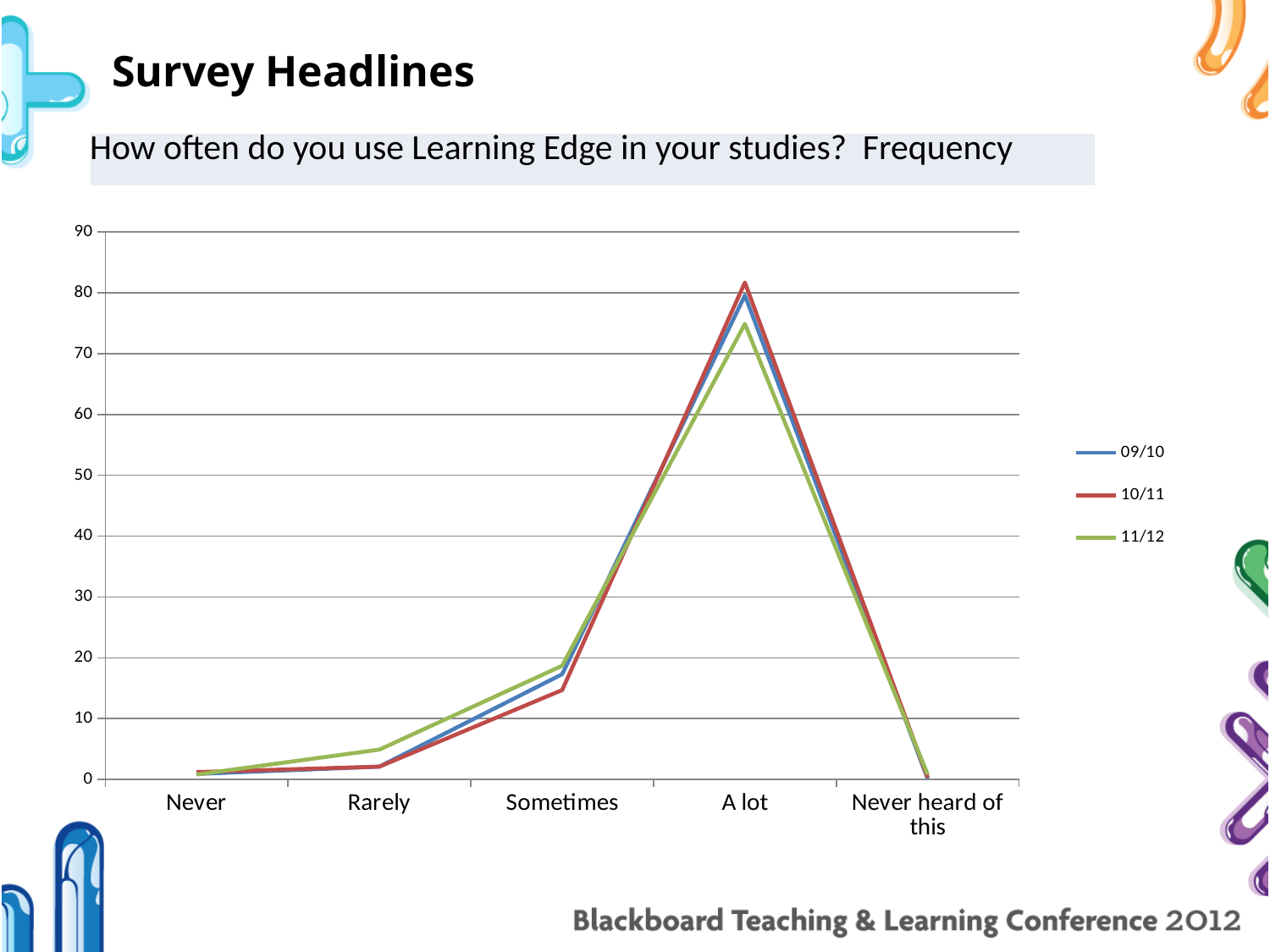
What are the three series listed in the chart's legend? 09/10, 10/11, 11/12 Which category has the highest value for the 11/12 series? A lot For the A lot category, which series has the larger value, 10/11 or 11/12? 10/11 Which category has the highest value for the 10/11 series? A lot Do the values for the 10/11 series rise or fall from Never to A lot? rise What kind of chart is shown on the slide? line chart How many series does the chart's legend list? 3 Is the value for Sometimes in the 11/12 series greater or less than 20? less Is the value for Rarely in the 11/12 series greater or less than 10? less How many categories are shown on the x axis of the chart? 5 Is the value for A lot in the 11/12 series greater or less than 70? greater